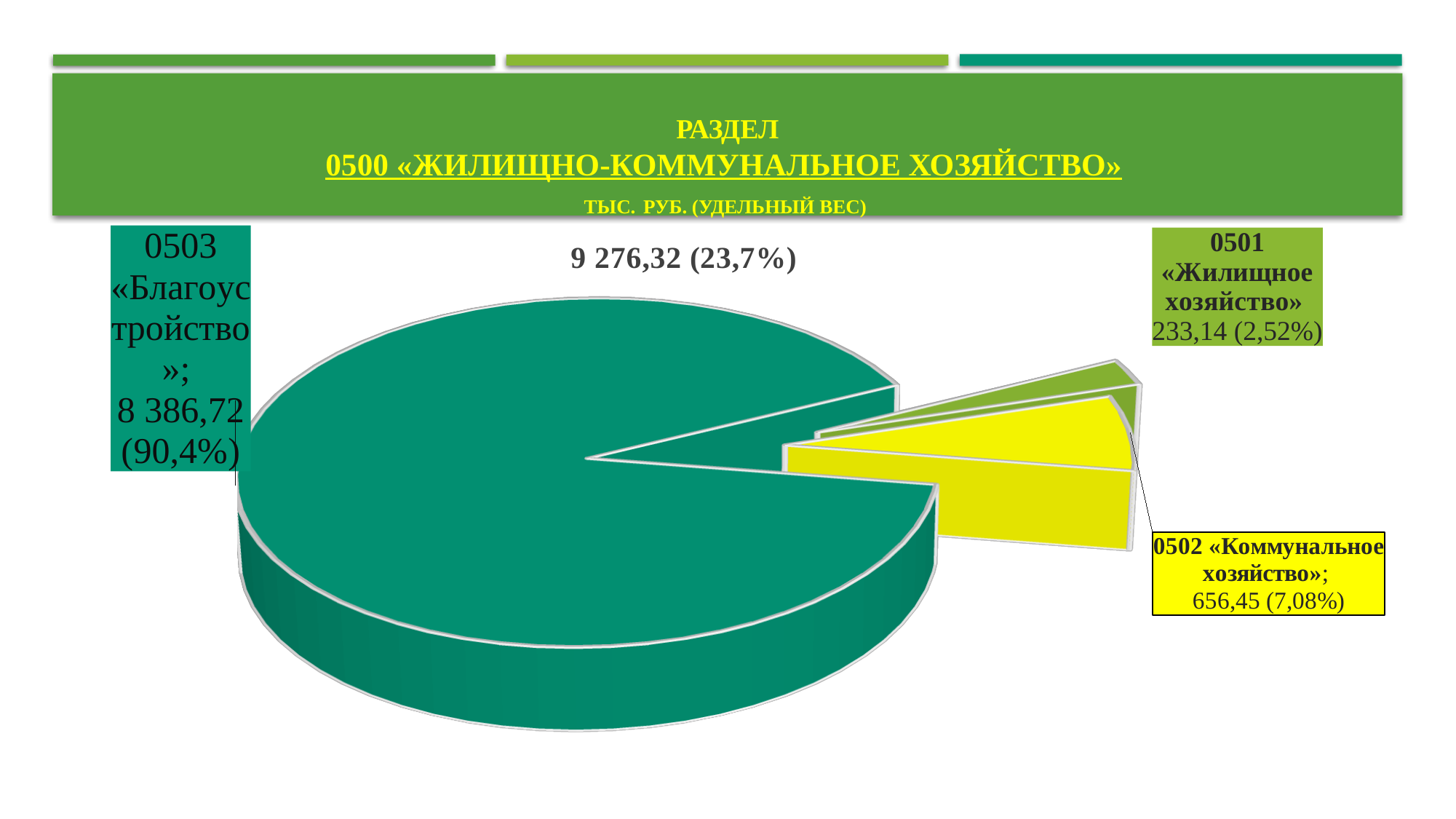
What total value is printed above the pie chart? 9 276,32 (23,7%) Which is larger, the value for 0502 «Коммунальное хозяйство» or for 0501 «Жилищное хозяйство»? 0502 «Коммунальное хозяйство» What share of the pie does 0501 «Жилищное хозяйство» account for? 2,52% What is the value shown for 0501 «Жилищное хозяйство»? 233,14 Which category has the largest slice of the pie? 0503 «Благоустройство» How many slices does the pie chart have? 3 What is the value shown for 0503 «Благоустройство»? 8 386,72 Which category has the smallest slice of the pie? 0501 «Жилищное хозяйство» What is the value shown for 0502 «Коммунальное хозяйство»? 656,45 What share of the pie does 0503 «Благоустройство» account for? 90,4% What share of the pie does 0502 «Коммунальное хозяйство» account for? 7,08% What kind of chart is shown on the slide? pie chart